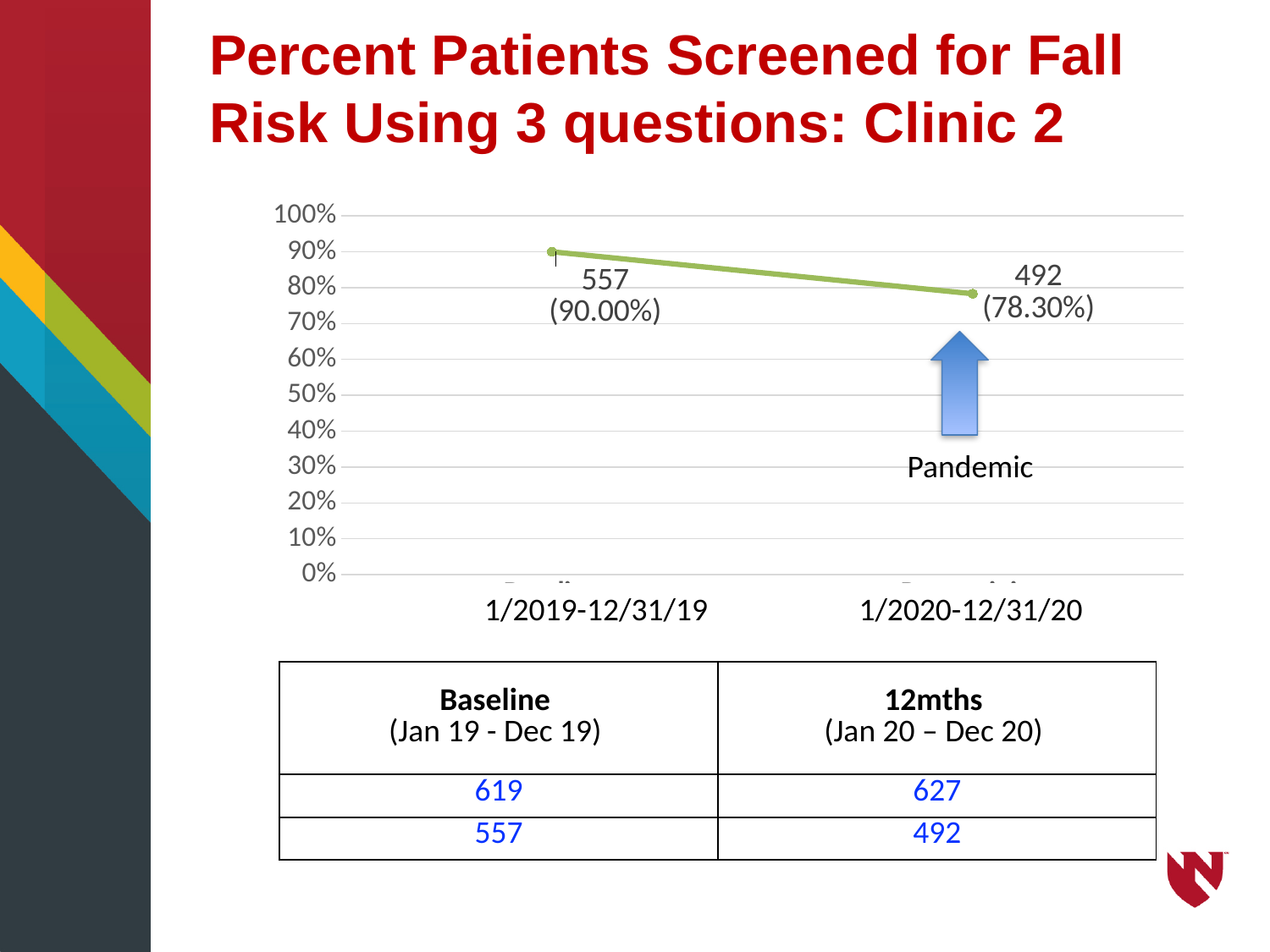
Which period has the lower percentage of patients screened? 1/2020-12/31/20 What percentage of patients were screened for fall risk in the 1/2019-12/31/19 period? 90.00% How many patients were screened in the 1/2020-12/31/20 period according to the chart's data label? 492 What type of chart is shown on the slide? line chart What event does the arrow annotation on the chart label? Pandemic What percentage of patients were screened for fall risk in the 1/2020-12/31/20 period? 78.30% Is the value for 1/2020-12/31/20 greater or less than 80%? less By how many percentage points did the screening rate drop from 1/2019-12/31/19 to 1/2020-12/31/20? 11.70 Does the screening percentage rise or fall from the 2019 period to the 2020 period? fall How many data points are plotted on the line? 2 How many patients were screened in the 1/2019-12/31/19 period according to the chart's data label? 557 Which period has the higher percentage of patients screened? 1/2019-12/31/19